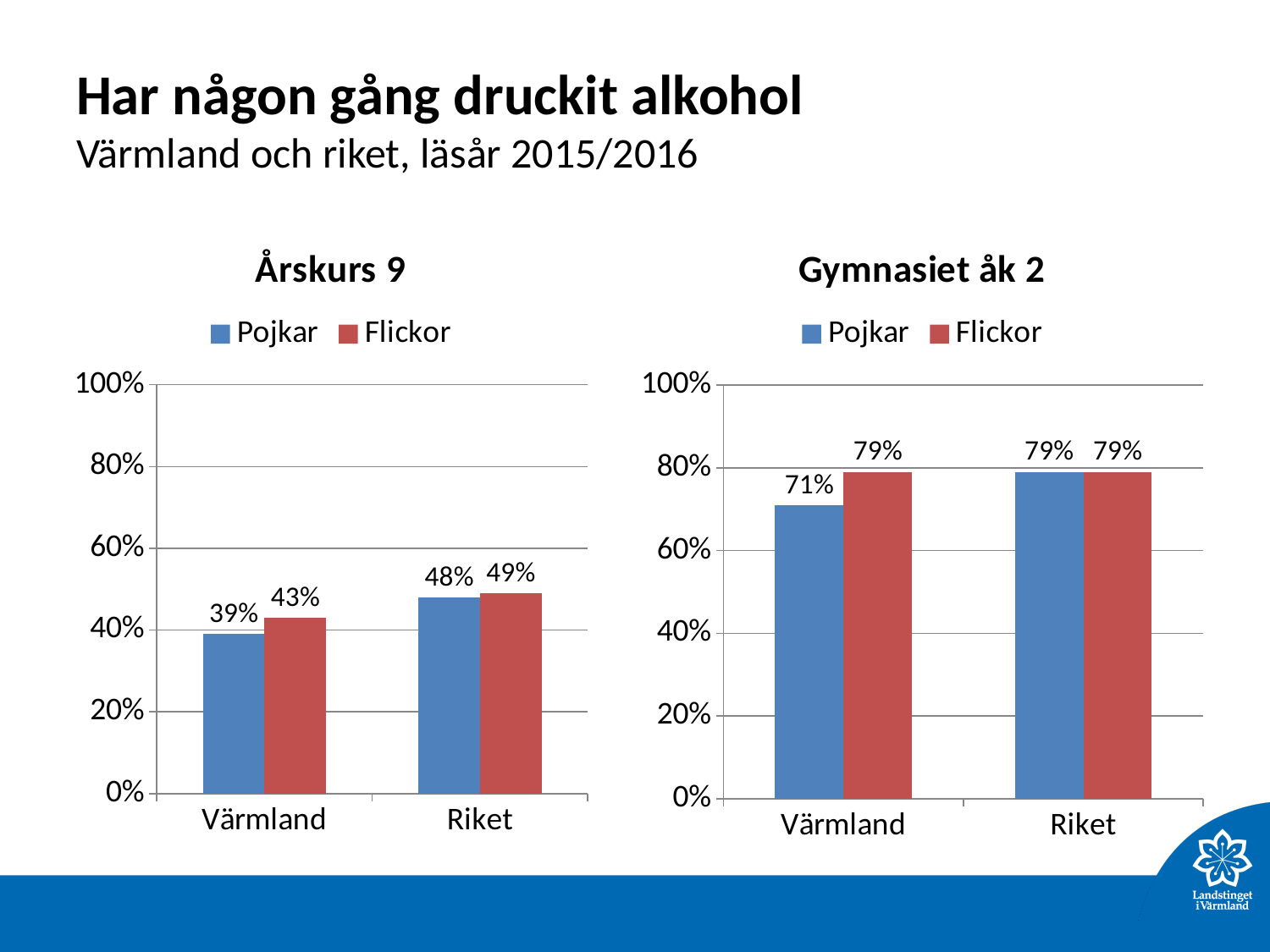
In the 'Gymnasiet åk 2' chart, what is the difference between Flickor and Pojkar in Värmland? 8 percentage points How many categories are shown on the x axis of the 'Årskurs 9' chart? 2 In the 'Årskurs 9' chart, which bar has the lowest value? Pojkar in Värmland In the 'Årskurs 9' chart, what is the value for Flickor in Riket? 49% In the 'Årskurs 9' chart, what is the difference between Flickor and Pojkar in Värmland? 4 percentage points In the 'Gymnasiet åk 2' chart, what is the value for Flickor in Riket? 79% In the 'Gymnasiet åk 2' chart, which bar has the lowest value? Pojkar in Värmland How many series does the legend of the 'Gymnasiet åk 2' chart list? 2 What kind of chart is the 'Årskurs 9' chart? Bar chart In the 'Årskurs 9' chart, what is the value for Pojkar in Värmland? 39% In the 'Årskurs 9' chart, which is larger: Pojkar in Värmland or Pojkar in Riket? Pojkar in Riket In the 'Gymnasiet åk 2' chart, what is the value for Pojkar in Värmland? 71%